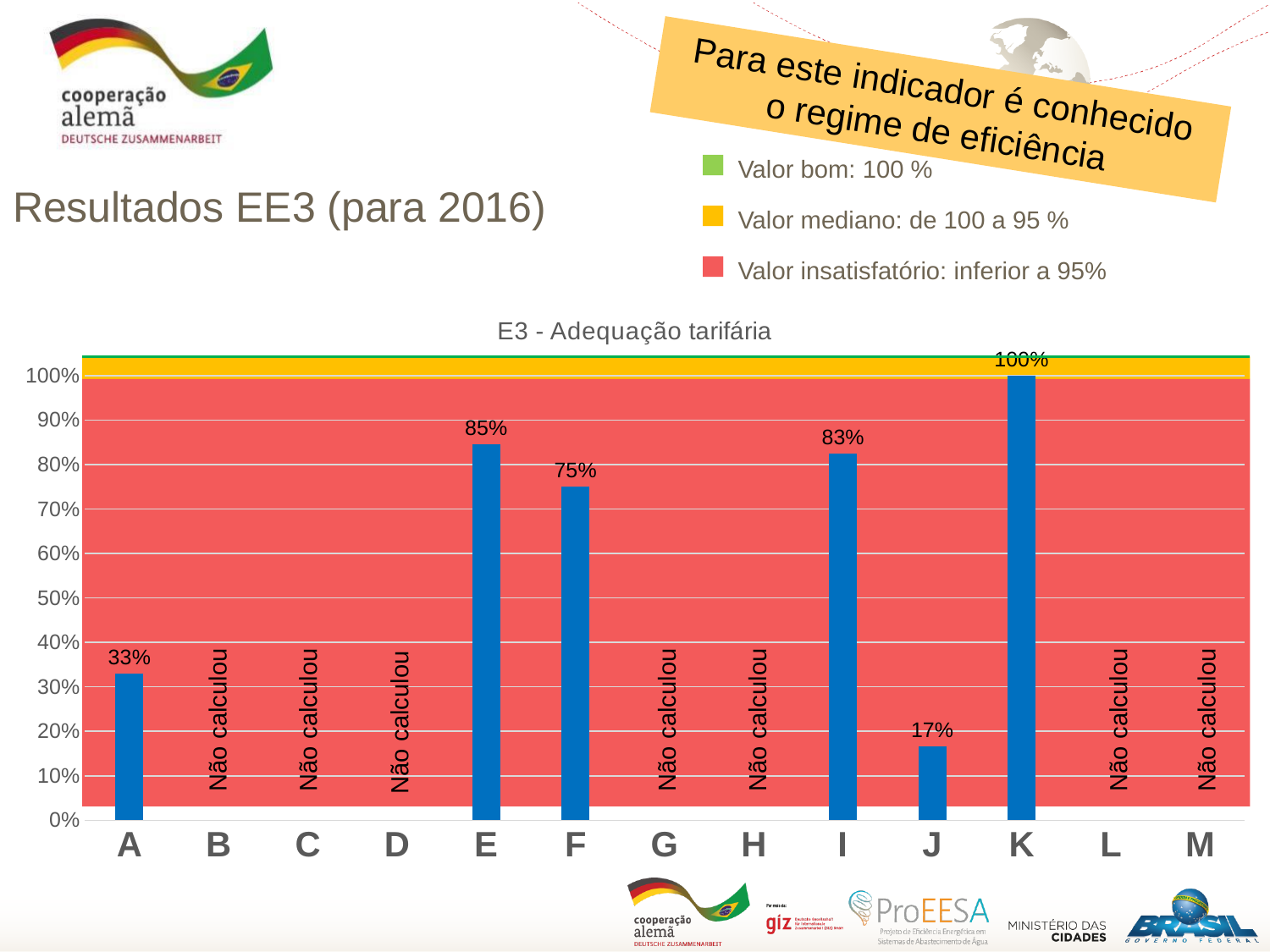
What kind of chart is shown? bar chart What is the value for category J? 17% What is the value for category K? 100% How many categories are shown on the x axis? 13 What is the difference between the values for E and F? 10% Which is larger, the value for E or the value for I? E What is the value for category A? 33% What is the value for category E? 85% How many categories are labelled "Não calculou"? 7 Which category has the highest value? K Among the categories with a plotted value, which has the lowest value? J What is the title of the chart? E3 - Adequação tarifária